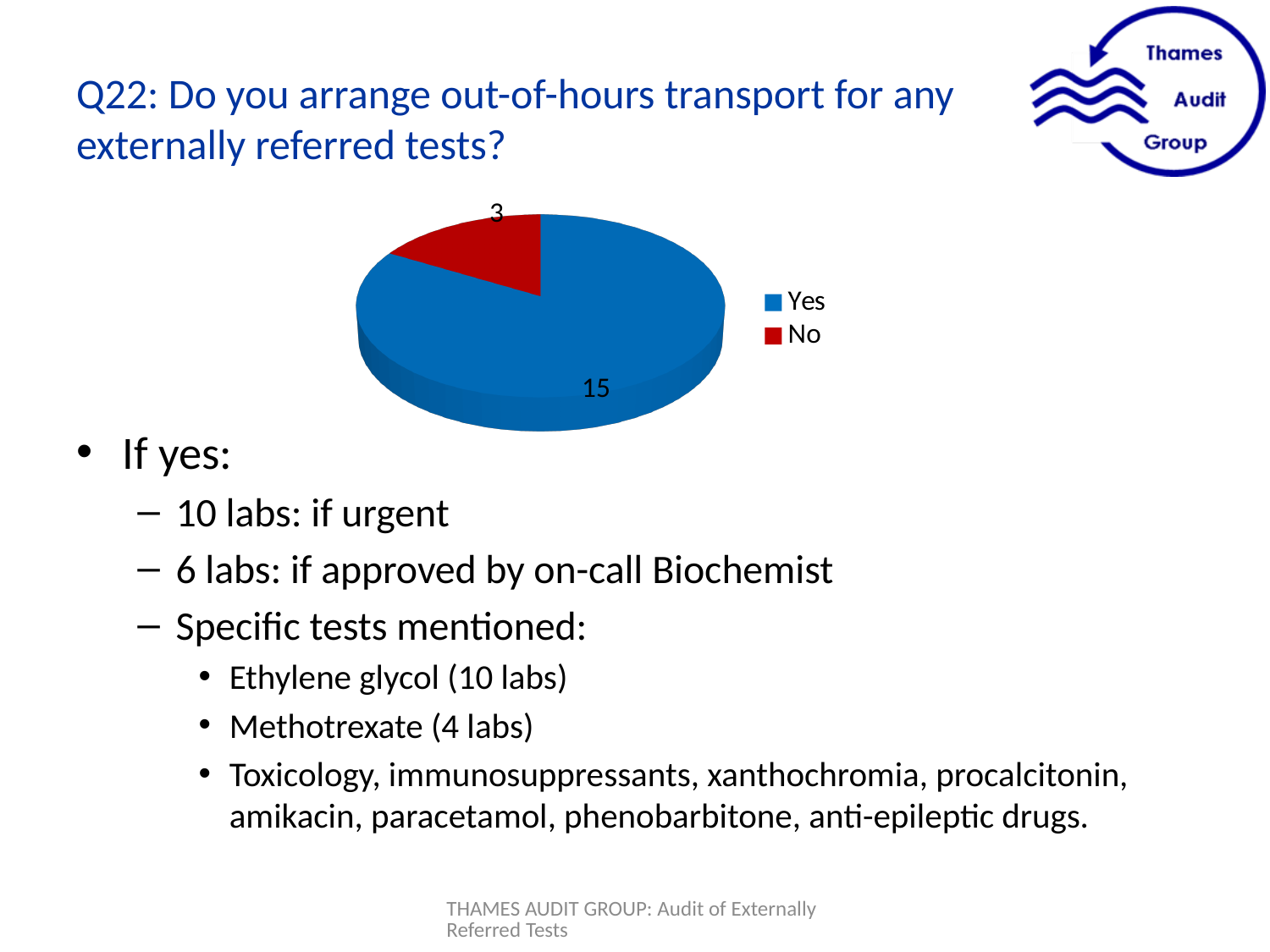
What colour is the No slice in the pie chart? red How many categories does the pie chart show? 2 What is the value for No in the pie chart? 3 What is the value for Yes in the pie chart? 15 Which is larger in the pie chart, Yes or No? Yes What is the difference between the Yes and No values in the pie chart? 12 What kind of chart is shown on the slide? pie chart What is the total of all slices in the pie chart? 18 Which category has the smallest slice in the pie chart? No Which category has the largest slice in the pie chart? Yes What colour is the Yes slice in the pie chart? blue How many entries does the legend of the pie chart list? 2